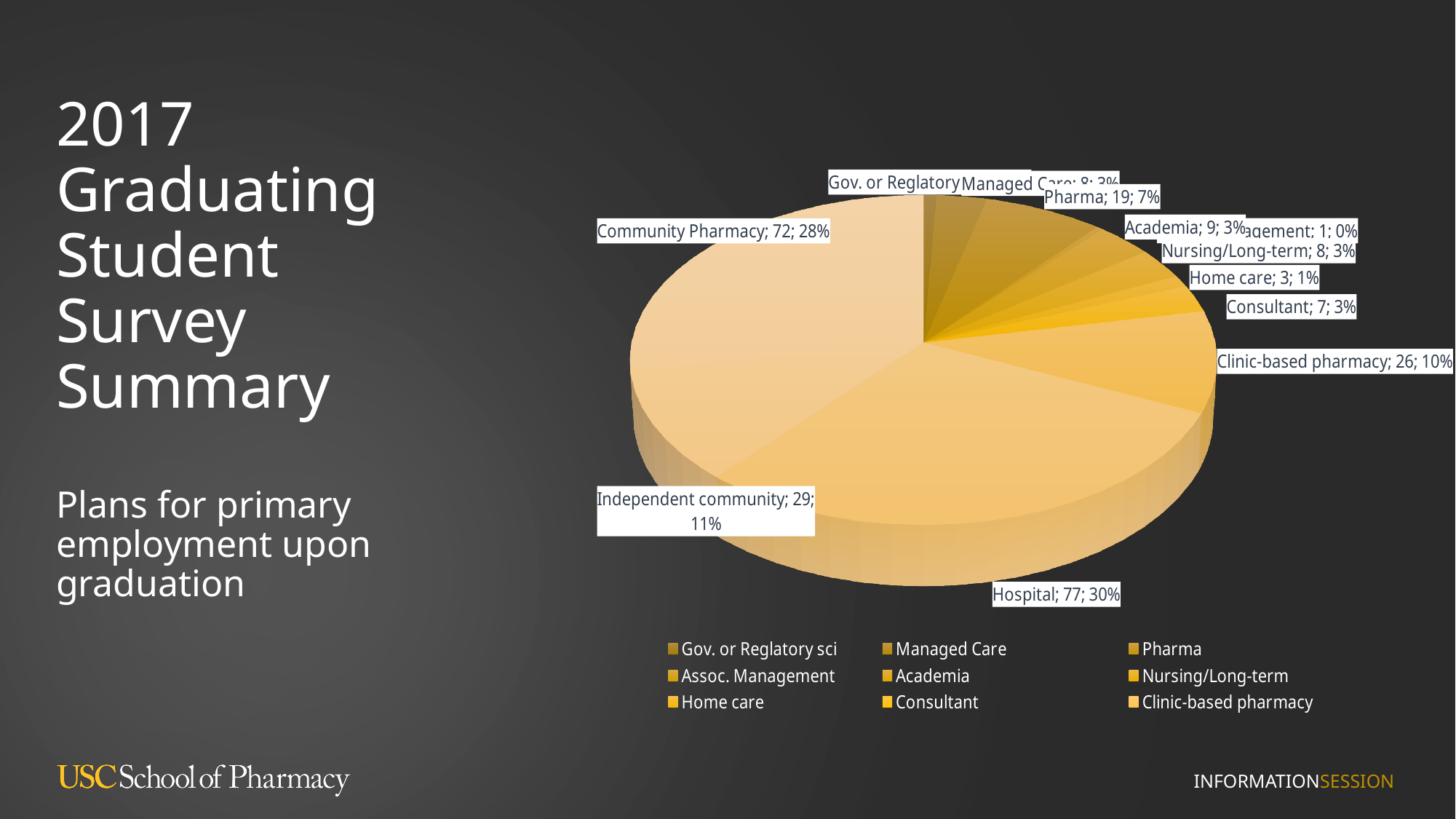
What is the value shown for Community Pharmacy? 72 What is the value shown for Nursing/Long-term? 8 What percentage of the pie does Hospital represent? 30% Which category has the largest slice of the pie? Hospital What is the value shown for Clinic-based pharmacy? 26 How many graduates plan to work in Hospital? 77 What percentage share does Community Pharmacy have? 28% What kind of chart is shown on the slide? Pie chart What is the difference between the Hospital value and the Community Pharmacy value? 5 What does the chart on the slide show, according to the text on the left? Plans for primary employment upon graduation What percentage share does Pharma have? 7% Which is larger, Independent community or Clinic-based pharmacy? Independent community